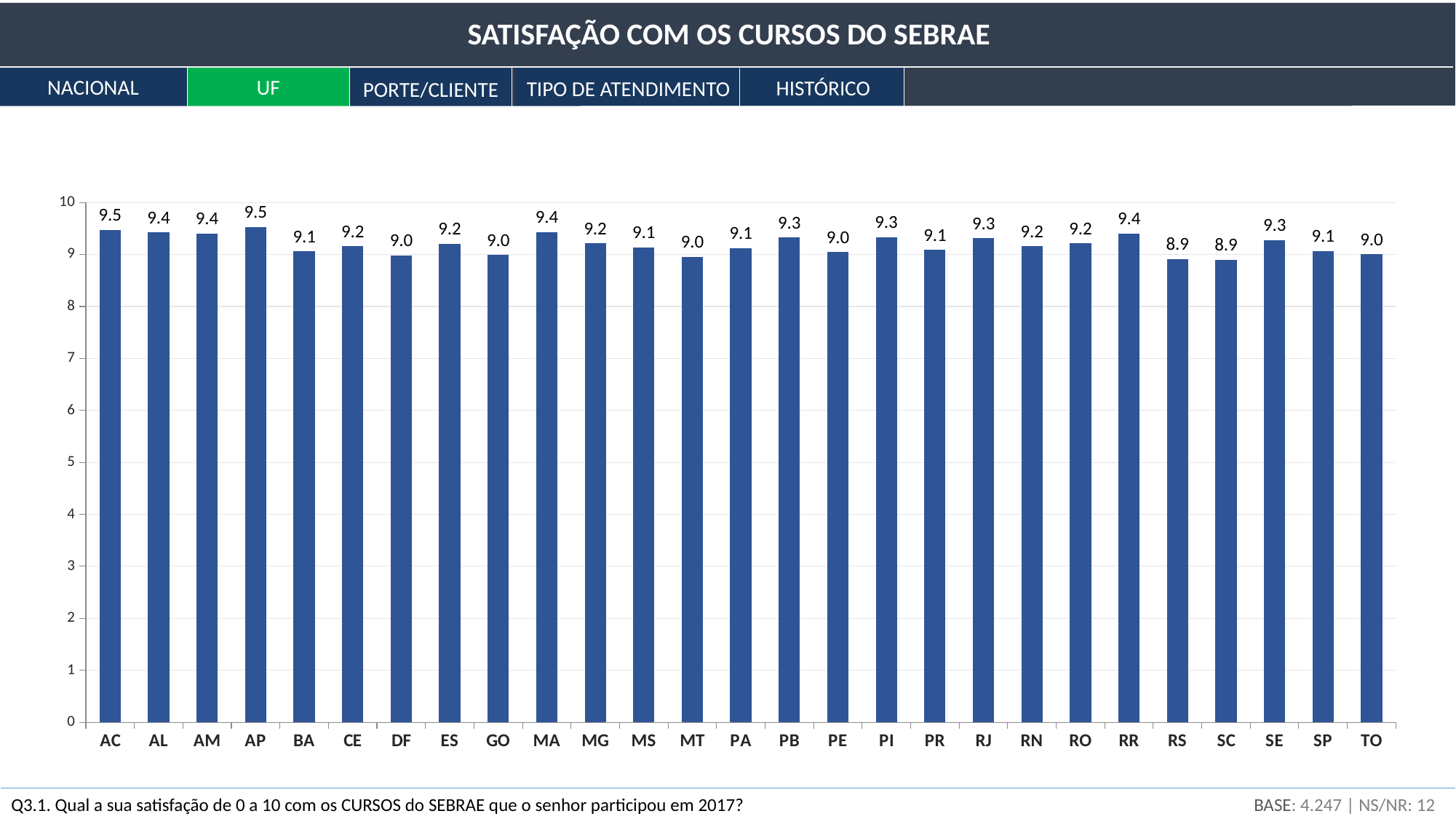
What is the satisfaction value for PB? 9.3 What kind of chart is shown on the slide? bar chart How many states (UF) are shown on the x axis? 27 What is the difference between the values for MA and DF? 0.4 What is the satisfaction value for RR? 9.4 What is the title of the slide? SATISFAÇÃO COM OS CURSOS DO SEBRAE What is the satisfaction value for AC? 9.5 Is the value for RS greater or less than 8? greater What is the satisfaction value for MT? 9.0 Which has a higher value, AC or SC? AC What is the satisfaction value for SC? 8.9 What is the difference between the values for AP and RS? 0.6